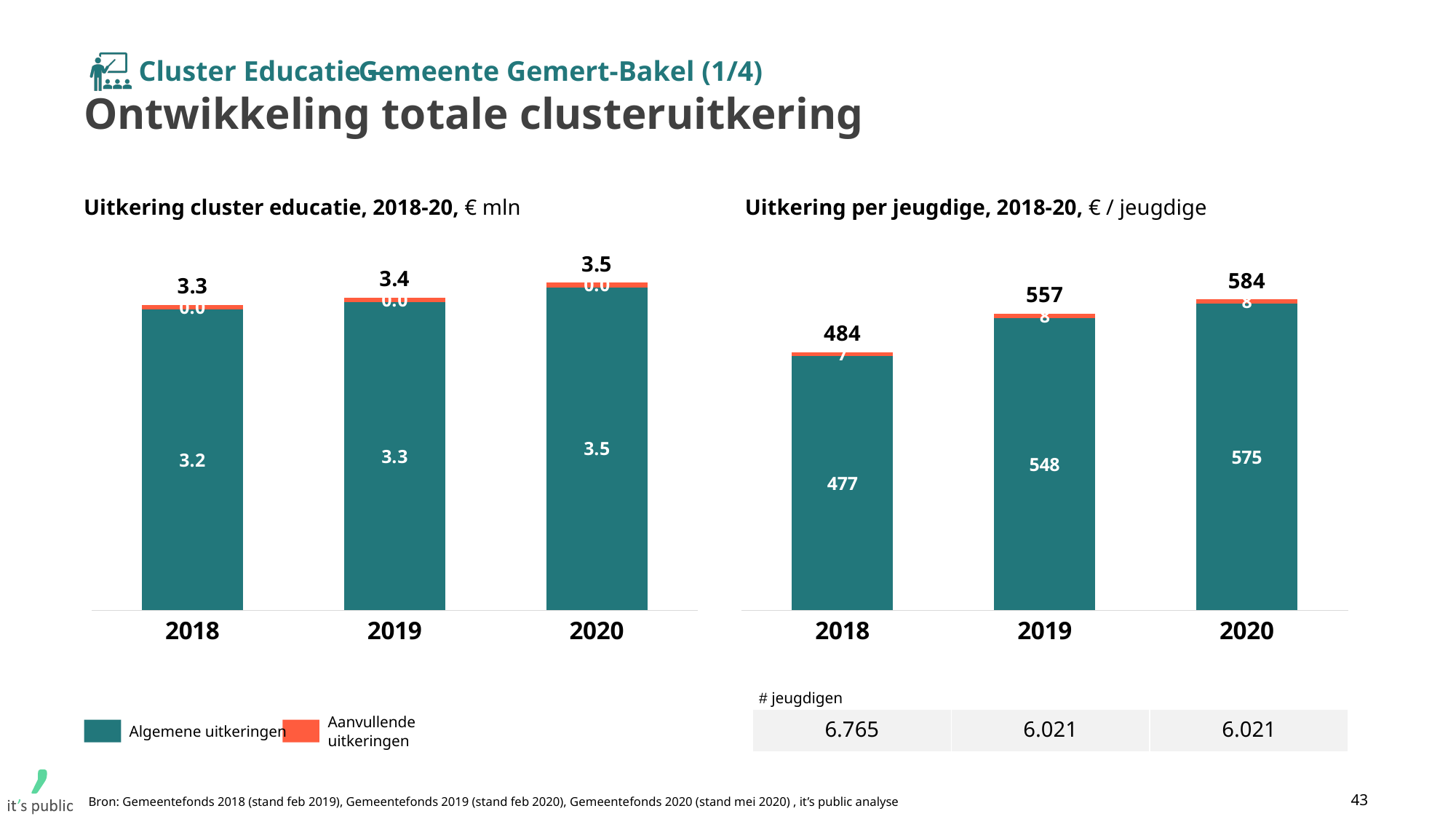
In the chart 'Uitkering cluster educatie, 2018-20', what is the total of the stacked bar for 2020? 3.5 In the chart 'Uitkering per jeugdige, 2018-20', what is the total of the stacked bar for 2018? 484 How many years are shown on the x axis of the chart 'Uitkering cluster educatie, 2018-20'? 3 How many series does the legend on the slide list? 2 In the chart 'Uitkering per jeugdige, 2018-20', which year has the highest total? 2020 In the chart 'Uitkering per jeugdige, 2018-20', which year has the lowest total? 2018 In the chart 'Uitkering per jeugdige, 2018-20', what is the value of Algemene uitkeringen for 2020? 575 In the chart 'Uitkering cluster educatie, 2018-20', do the totals rise or fall from 2018 to 2020? rise In the chart 'Uitkering per jeugdige, 2018-20', what is the value of Aanvullende uitkeringen for 2019? 8 In the chart 'Uitkering per jeugdige, 2018-20', what is the difference between the Algemene uitkeringen values for 2019 and 2018? 71 What kind of chart is 'Uitkering per jeugdige, 2018-20'? stacked bar chart In the chart 'Uitkering cluster educatie, 2018-20', what is the value of Algemene uitkeringen for 2019? 3.3